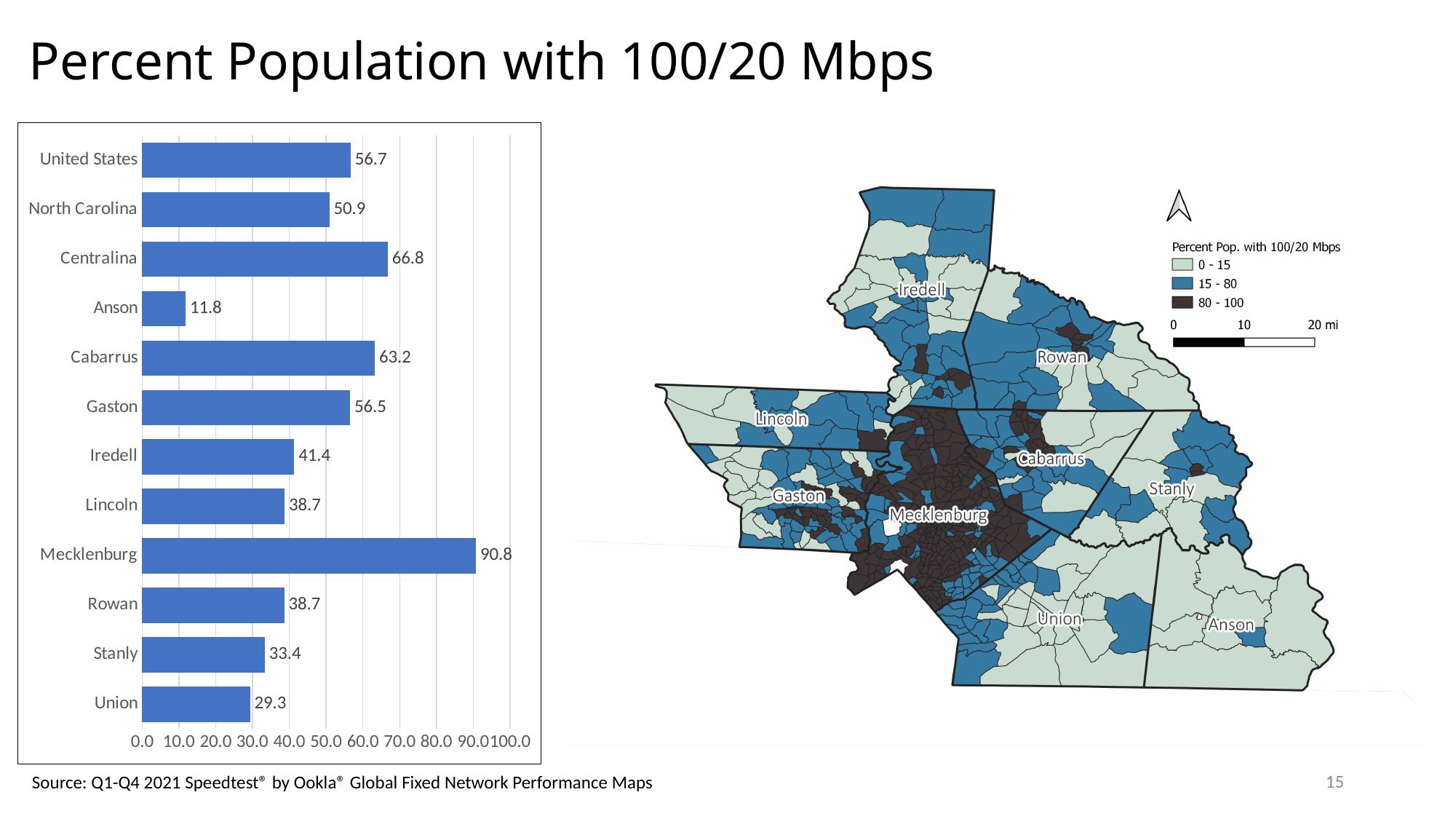
In the bar chart, what is the difference between the values for Centralina and North Carolina? 15.9 In the bar chart, is the value for Stanly greater or less than 40.0? less How many categories are shown in the bar chart? 12 What is the value for Centralina in the bar chart? 66.8 What kind of chart is shown on the left of the slide? bar chart In the bar chart, what is the difference between the values for Mecklenburg and Anson? 79.0 Which category has the lowest value in the bar chart? Anson What is the value for Anson in the bar chart? 11.8 What is the value for Mecklenburg in the bar chart? 90.8 What is the value for North Carolina in the bar chart? 50.9 In the bar chart, which is larger, the value for Cabarrus or the value for Gaston? Cabarrus Which category has the highest value in the bar chart? Mecklenburg